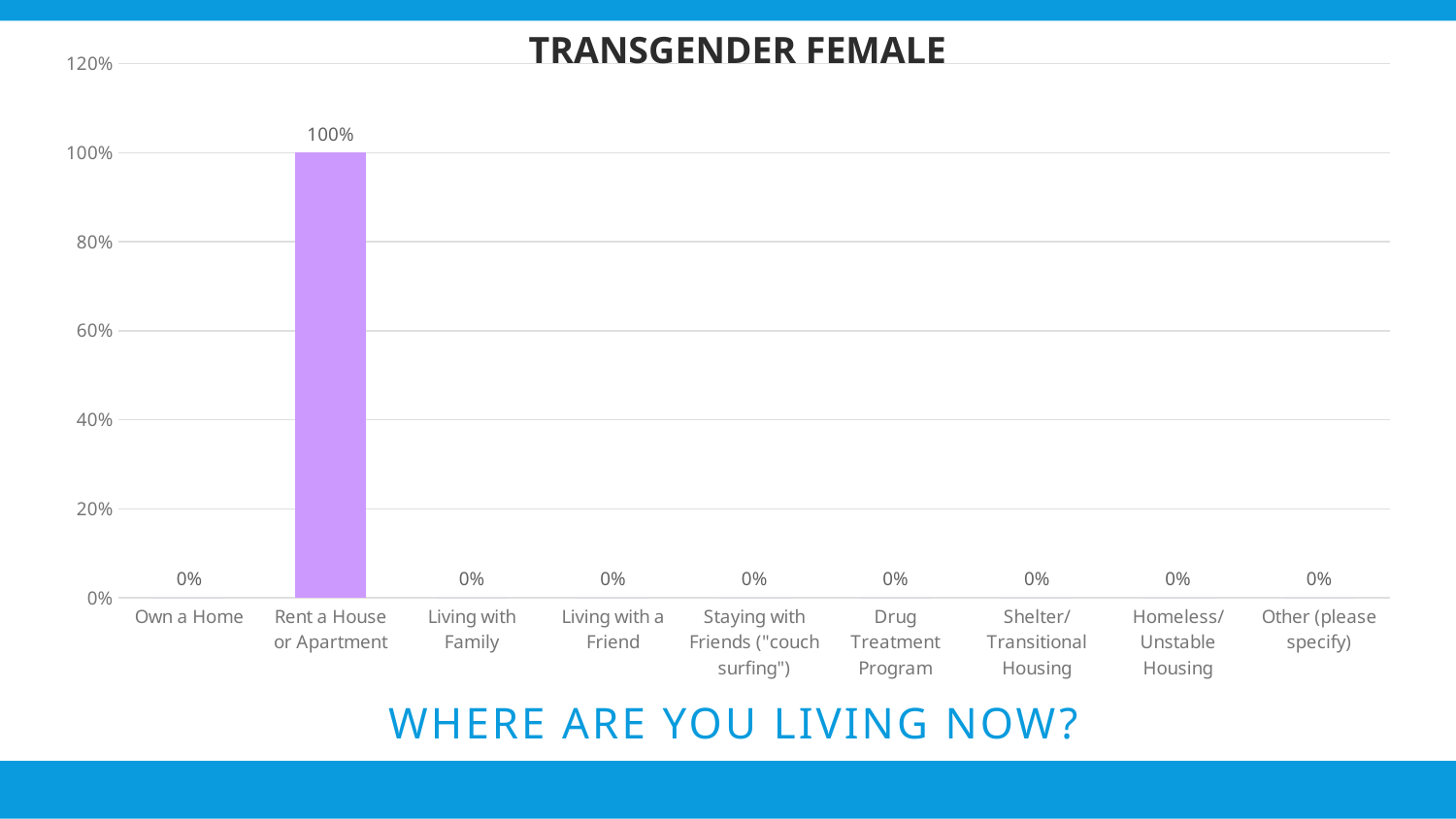
What is the difference between the values for Rent a House or Apartment and Living with Family? 100% Is the value for Rent a House or Apartment greater or less than 80%? greater What is the value for Homeless/Unstable Housing? 0% What is the title of the chart? TRANSGENDER FEMALE What is the value for Rent a House or Apartment? 100% What is the value for Other (please specify)? 0% What is the value for Own a Home? 0% How many categories have a value of 0%? 8 Which is larger, the value for Rent a House or Apartment or the value for Drug Treatment Program? Rent a House or Apartment What kind of chart is shown on the slide? bar chart How many categories are shown on the x axis? 9 Which category has the highest value? Rent a House or Apartment